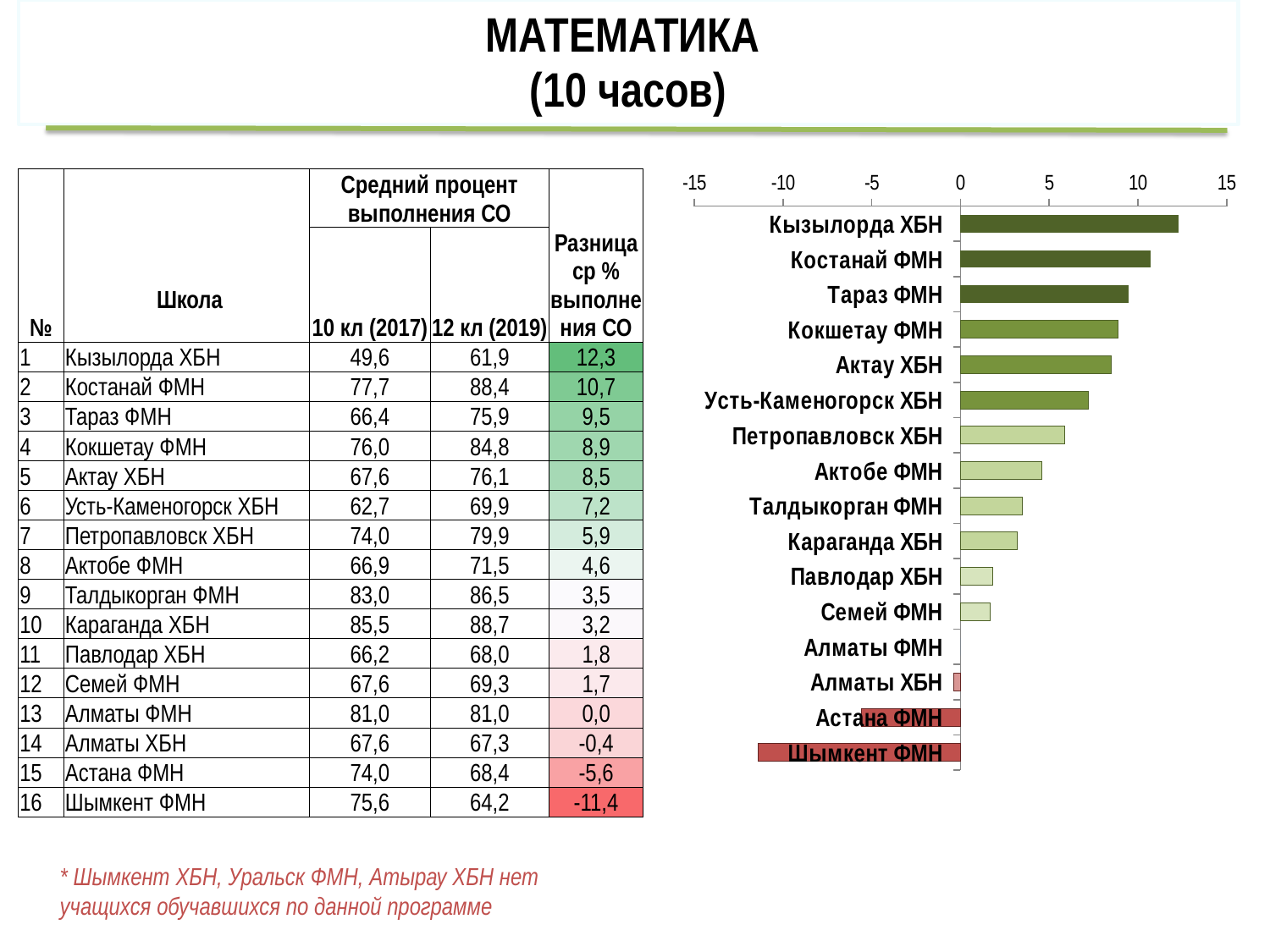
In the bar chart, which school has the larger value, Петропавловск ХБН or Талдыкорган ФМН? Петропавловск ХБН In the bar chart, is the value for Кызылорда ХБН greater or less than 10? greater In the bar chart, is the value for Шымкент ФМН greater or less than -10? less Which school has the highest value in the bar chart? Кызылорда ХБН What is the difference in average completion percentage (Разница) for Кызылорда ХБН, as shown in the table? 12,3 Do the bar values rise or fall going from the top school to the bottom school in the bar chart? fall Which school has the lowest value in the bar chart? Шымкент ФМН In the bar chart, which school has the larger value, Костанай ФМН or Тараз ФМН? Костанай ФМН How many schools are plotted in the bar chart? 16 What kind of chart is shown on the right of the slide? bar chart